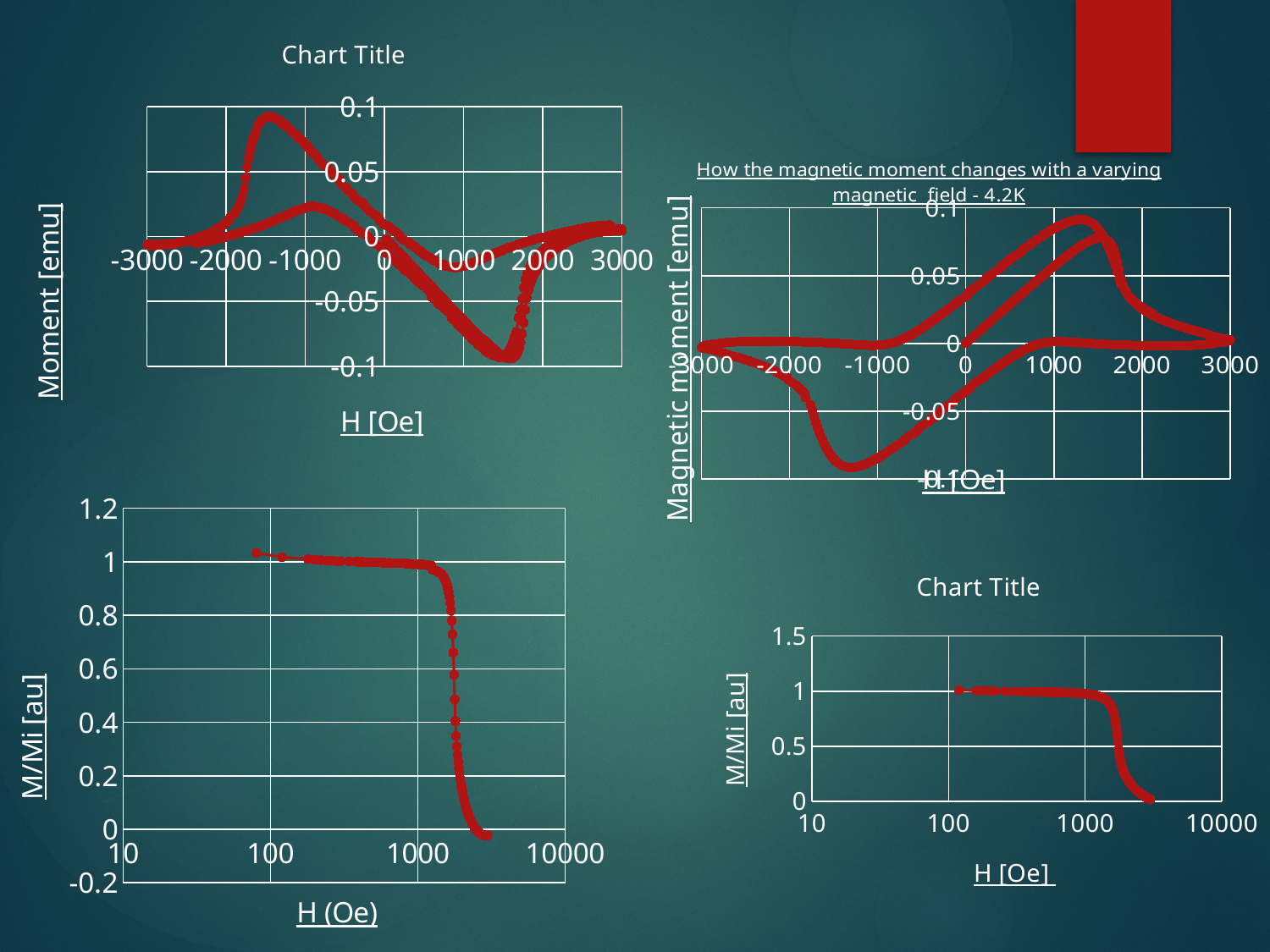
In the bottom-left chart, is the M/Mi value at H = 3000 greater or less than 0.5? less What kind of chart is the bottom-left chart with the M/Mi [au] axis? scatter chart In the bottom-right chart titled 'Chart Title', is the M/Mi value at H = 3000 greater or less than 0.5? less What is the y-axis title of the bottom-left chart? M/Mi [au] What is the title of the top-right chart? How the magnetic moment changes with a varying magnetic field - 4.2K In the bottom-right chart titled 'Chart Title', is the M/Mi value at H = 100 greater or less than 0.5? greater In the bottom-right chart titled 'Chart Title', does M/Mi rise or fall as H increases from 1000 to 3000? fall In the bottom-left chart, does M/Mi rise or fall as H increases from 1000 to 3000? fall What kind of chart is the top-right chart titled 'How the magnetic moment changes with a varying magnetic field - 4.2K'? scatter chart